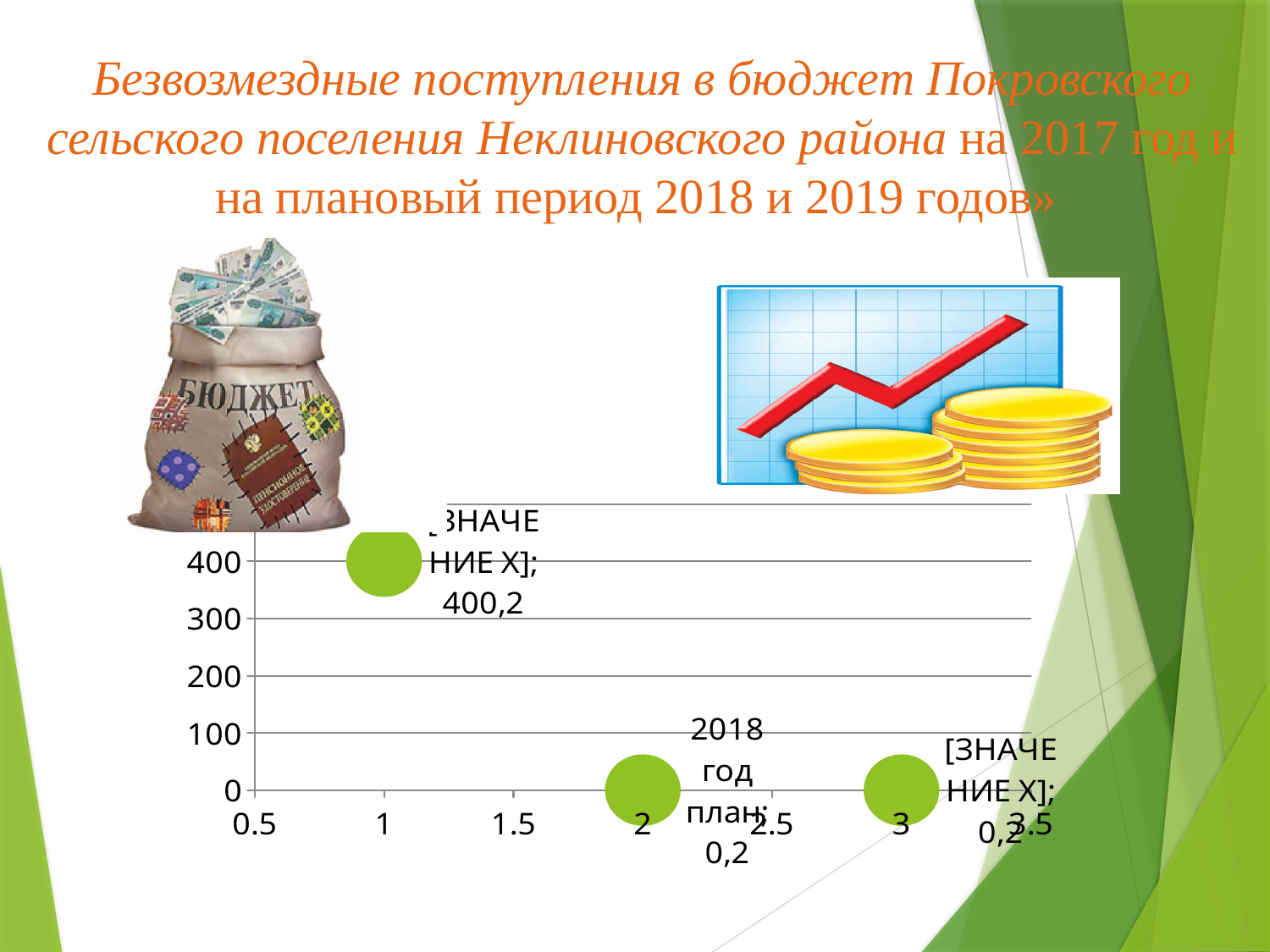
What is the value of the data point labelled "2018 год план"? 0,2 What is the value of the data point at x = 1? 400,2 Is the value of the data point at x = 2 greater or less than 100? less Do the values rise or fall from the first point to the second point along the x axis? fall Which data point has the highest value? the point at x = 1 What is the value of the data point at x = 3? 0,2 What is the difference between the value at x = 1 and the value at x = 2? 400 Is the value of the data point at x = 1 greater or less than 300? greater How many data points are plotted on the chart? 3 Which is larger: the value at x = 1 or the value at x = 3? the value at x = 1 What kind of chart is shown on the slide? bubble chart What is the highest tick value shown on the vertical axis? 400